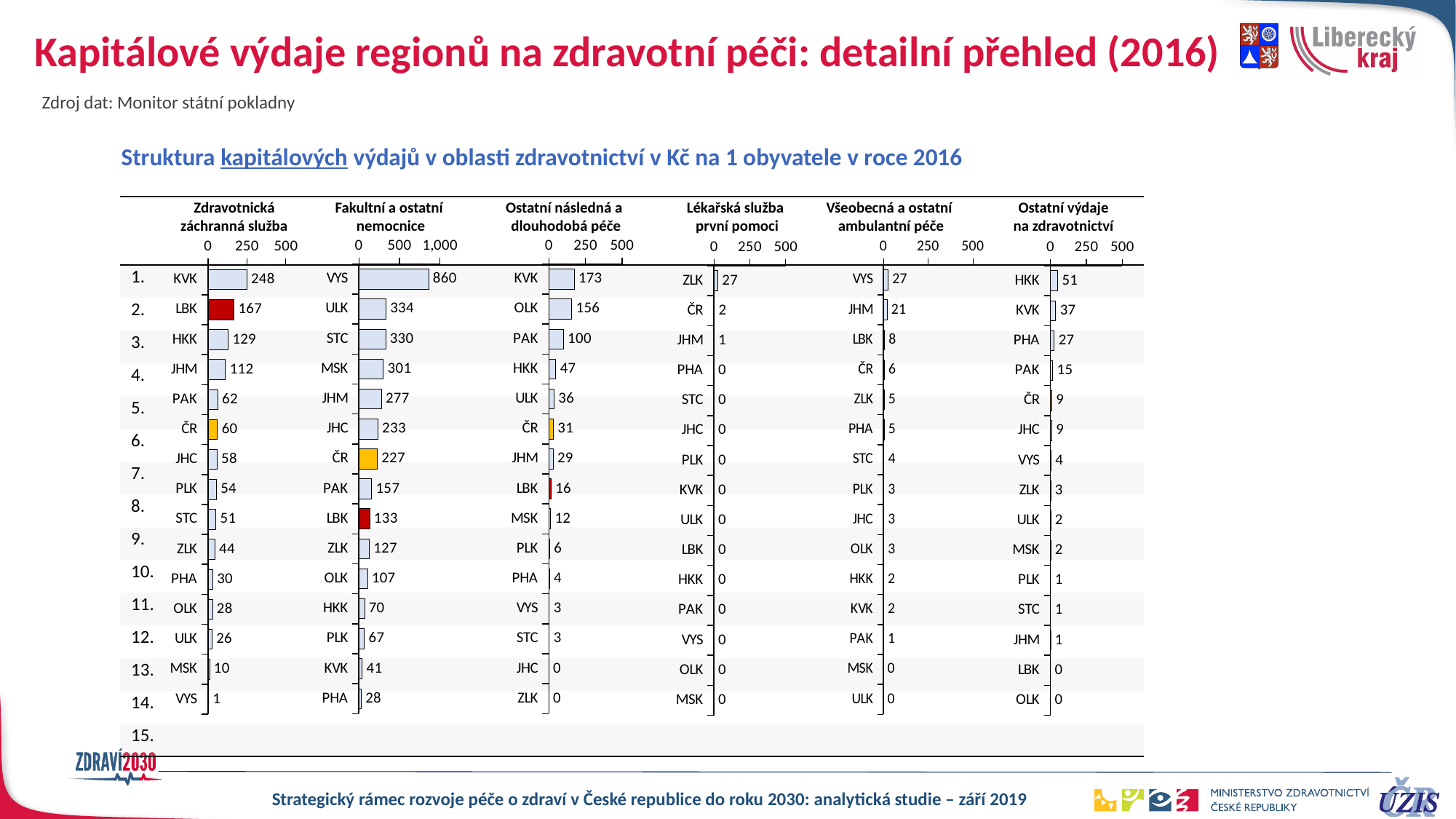
In the "Všeobecná a ostatní ambulantní péče" chart, what is the value for LBK? 8 In the "Fakultní a ostatní nemocnice" chart, which region has the highest value? VYS In the "Lékařská služba první pomoci" chart, which region has the highest value? ZLK In the "Zdravotnická záchranná služba" chart, what is the value for LBK? 167 In the "Fakultní a ostatní nemocnice" chart, what is the difference between VYS and ULK? 526 In the "Zdravotnická záchranná služba" chart, is the value for KVK greater or less than 250? less In the "Zdravotnická záchranná služba" chart, which region has the lowest value? VYS In the "Ostatní výdaje na zdravotnictví" chart, which is larger, HKK or KVK? HKK How many regions are listed in the "Fakultní a ostatní nemocnice" chart? 14 In the "Fakultní a ostatní nemocnice" chart, what is the value for ČR? 227 What kind of chart is used for "Zdravotnická záchranná služba"? Bar chart In the "Ostatní následná a dlouhodobá péče" chart, what is the difference between KVK and OLK? 17